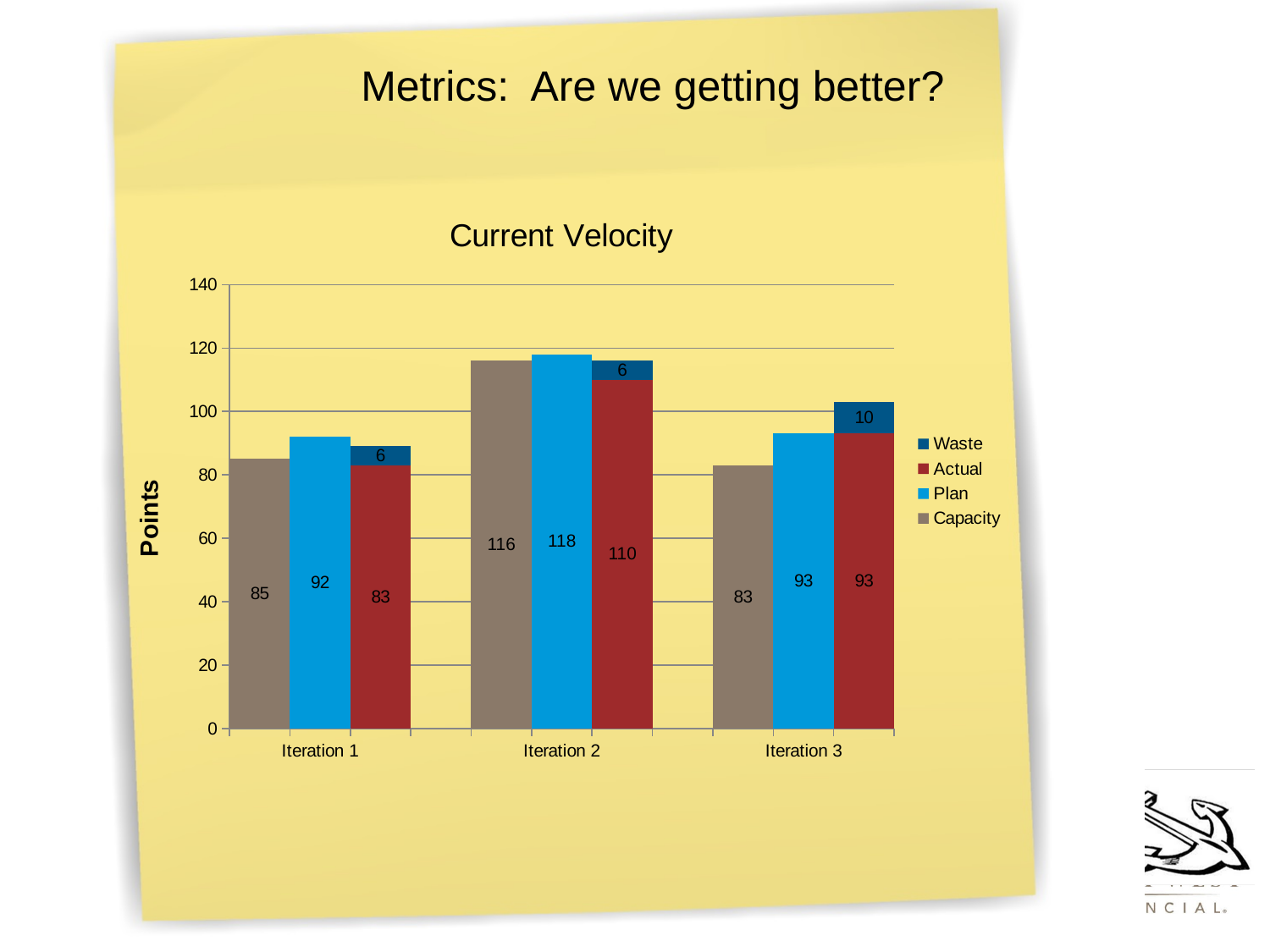
What is the total of the stacked Actual and Waste bar for Iteration 3? 103 How many series does the legend list? 4 Which iteration has the highest Plan value? Iteration 2 What kind of chart is shown? Bar chart What is the Actual value for Iteration 2? 110 Which iteration has the lowest Capacity value? Iteration 3 What is the difference between the Plan and Actual values for Iteration 1? 9 What is the title of the chart? Current Velocity What is the Plan value for Iteration 1? 92 What is the Waste value for Iteration 3? 10 Is the Capacity value for Iteration 1 larger than the Actual value for Iteration 1? Yes What is the Capacity value for Iteration 2? 116